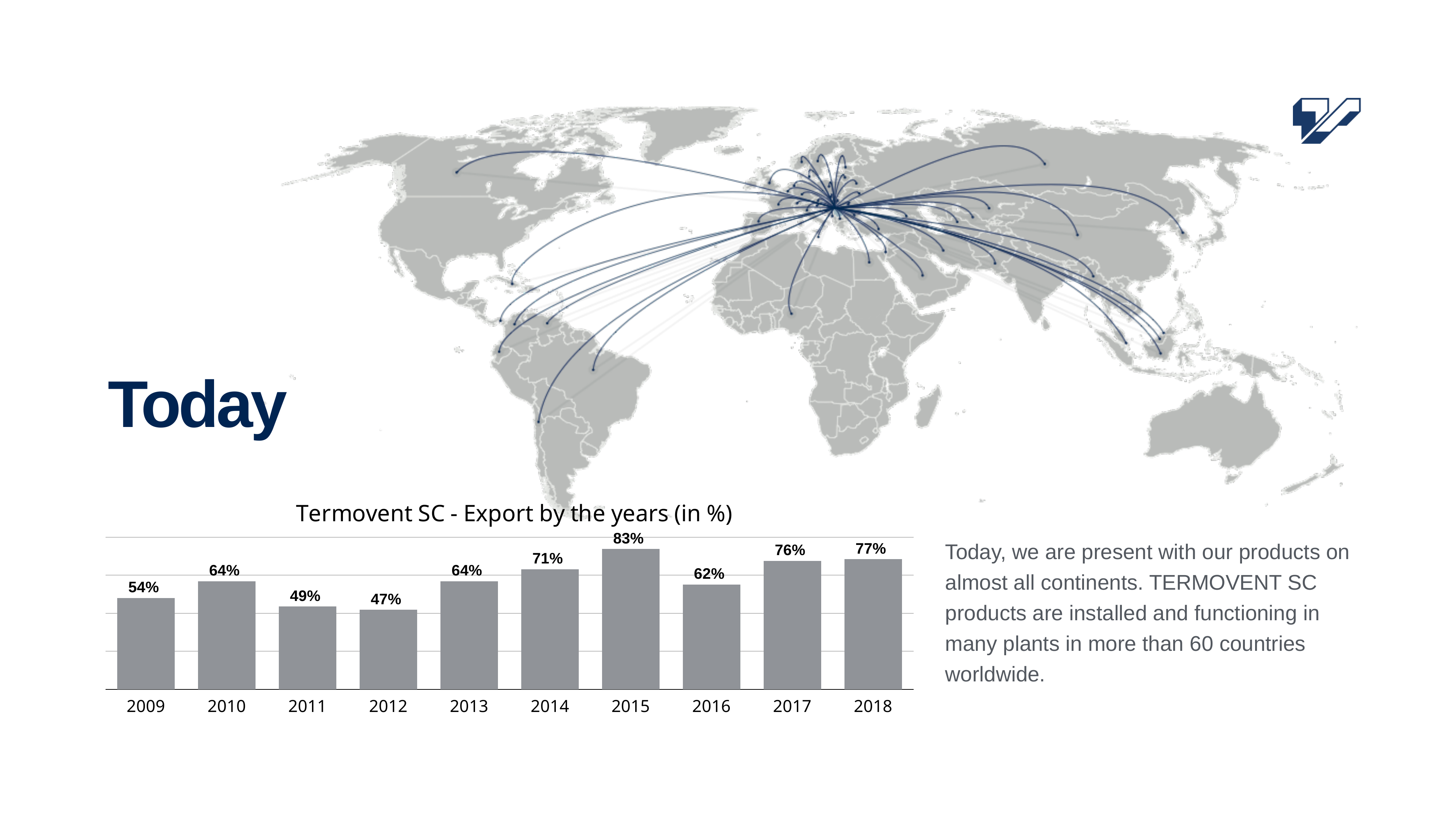
What is the difference between the export values for 2018 and 2009? 23% Which year has a larger export value, 2014 or 2017? 2017 What is the export value for 2018? 77% Which year has the highest export percentage? 2015 How many years are shown in the chart? 10 What is the export value for 2012? 47% What is the export value for 2015? 83% What is the title of the chart? Termovent SC - Export by the years (in %) Which year has the lowest export percentage? 2012 Which year has a larger export value, 2011 or 2016? 2016 What is the difference between the export values for 2015 and 2016? 21% What kind of chart is shown on the slide? Bar chart